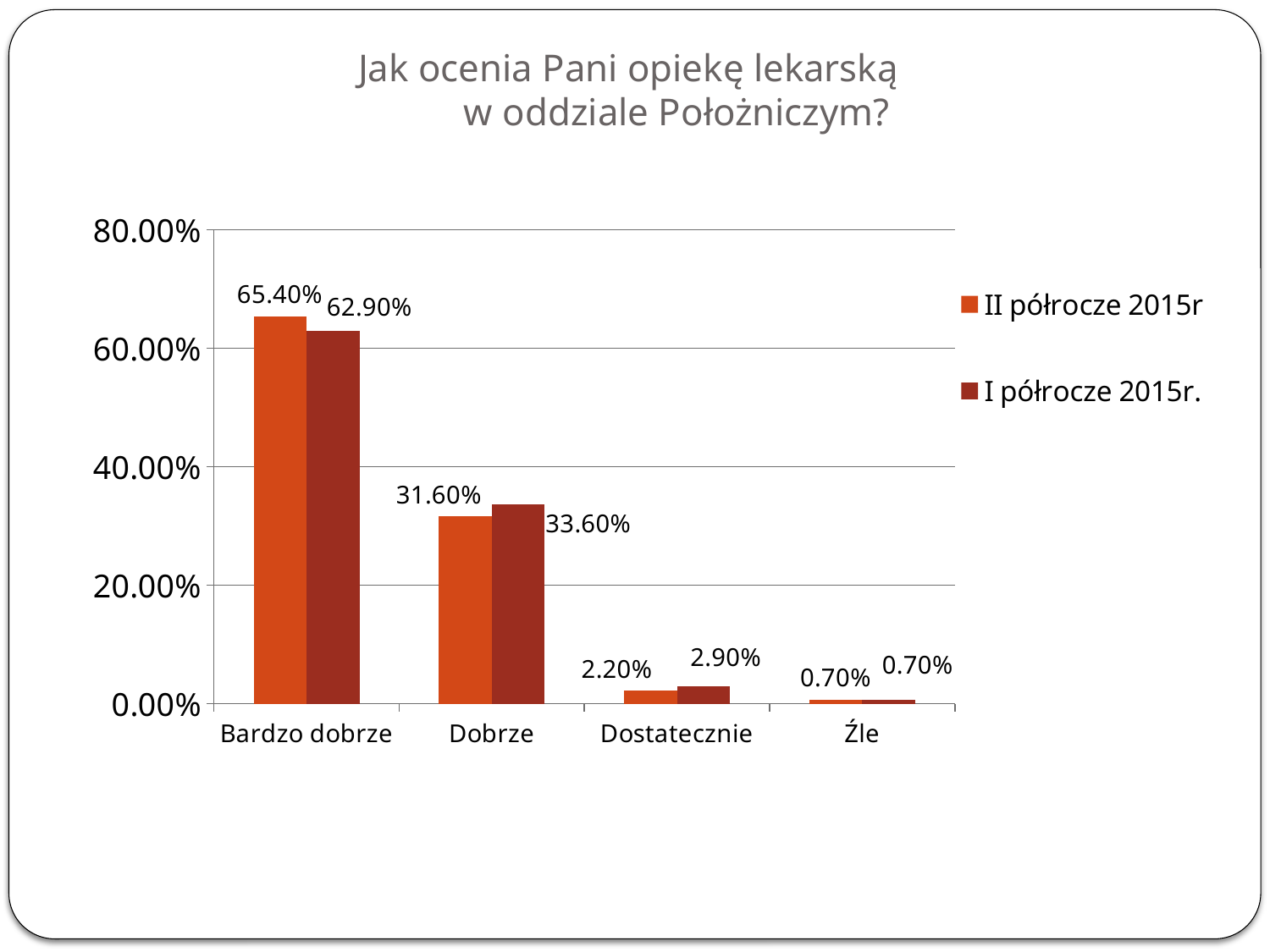
What is the title of the chart? Jak ocenia Pani opiekę lekarską w oddziale Położniczym? How many categories are shown on the x axis? 4 Is the value for "Bardzo dobrze" in the "II półrocze 2015r" series greater or less than 60.00%? greater What kind of chart is shown on the slide? bar chart What is the value for "Bardzo dobrze" in the "II półrocze 2015r" series? 65.40% How many series does the legend list? 2 Which category has the highest value in the "I półrocze 2015r." series? Bardzo dobrze What is the difference between the "II półrocze 2015r" and "I półrocze 2015r." values for "Bardzo dobrze"? 2.50% Which category has the lowest value in the "II półrocze 2015r" series? Źle What is the value for "Dobrze" in the "I półrocze 2015r." series? 33.60% What is the value for "Dostatecznie" in the "II półrocze 2015r" series? 2.20% For "Dobrze", which series has the larger value: "II półrocze 2015r" or "I półrocze 2015r."? I półrocze 2015r.